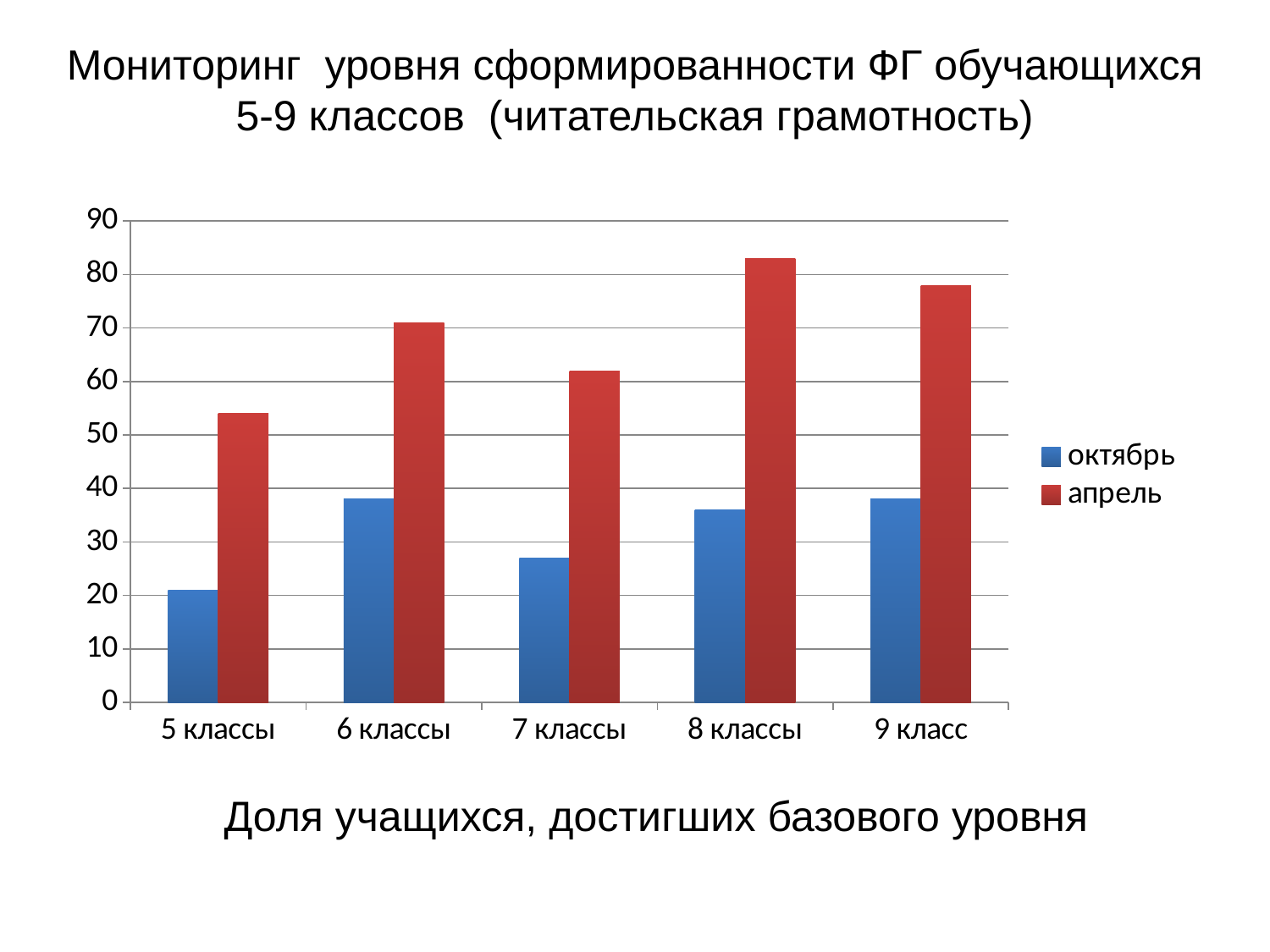
Which is larger for октябрь: 6 классы or 7 классы? 6 классы How many series does the legend list? 2 Which is larger for апрель: 8 классы or 9 класс? 8 классы How many class groups are shown on the x axis? 5 Is the value for апрель in 8 классы greater or less than 80? greater Which class group has the lowest value for октябрь? 5 классы What kind of chart is shown on the slide? bar chart What are the two series named in the legend? октябрь and апрель Is the value for октябрь in 7 классы greater or less than 40? less Which class group has the lowest value for апрель? 5 классы Which class group has the highest value for апрель? 8 классы Is the value for октябрь in 5 классы greater or less than 30? less